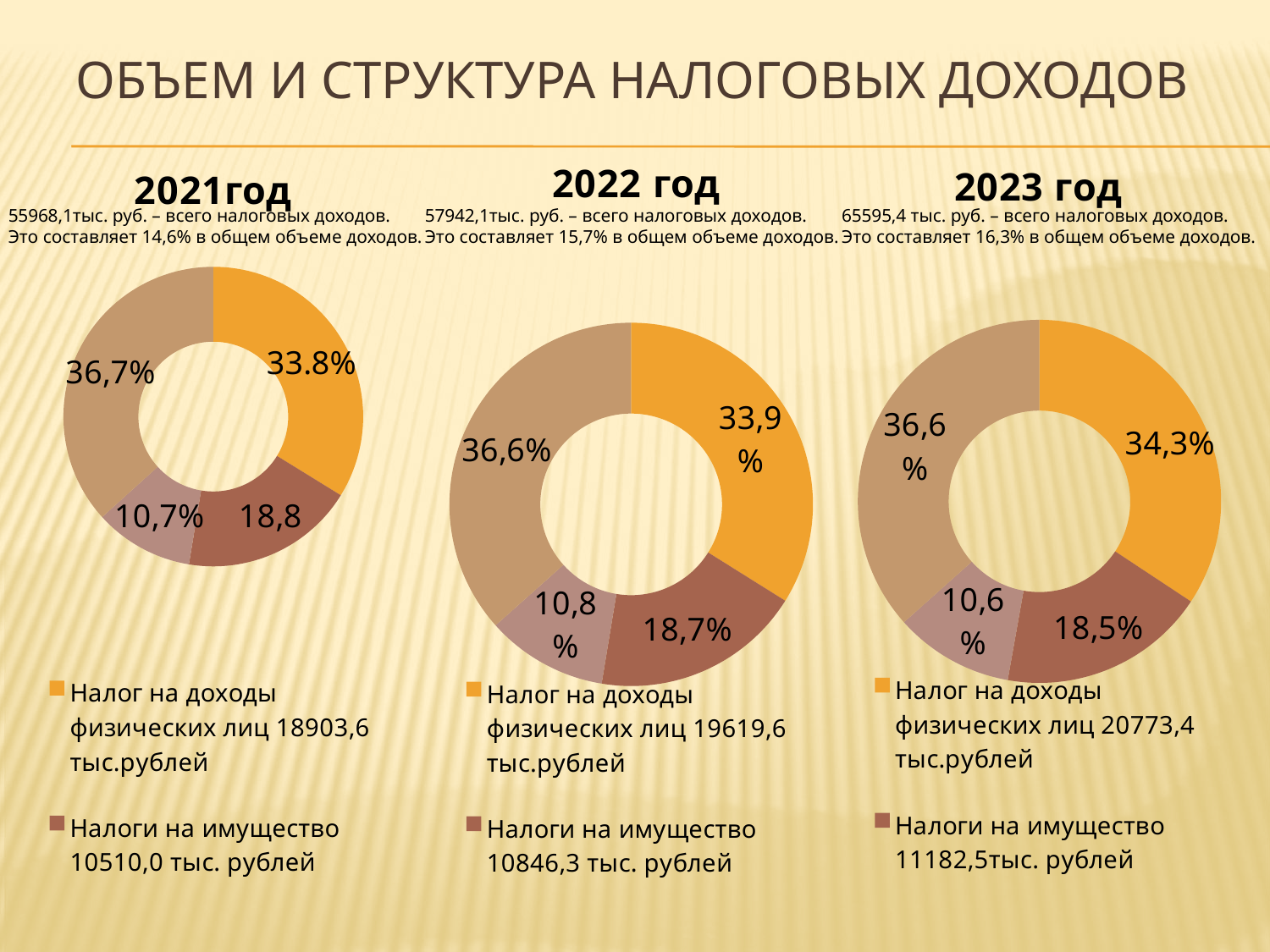
In the 2021 год chart, what is the smallest percentage shown? 10,7% Across the 2021, 2022 and 2023 charts, does the share for Налог на доходы физических лиц rise or fall? rise What is the title of the slide containing the three charts? ОБЪЕМ И СТРУКТУРА НАЛОГОВЫХ ДОХОДОВ According to the legend of the 2021 год chart, what amount is given for Налог на доходы физических лиц? 18903,6 тыс.рублей How many slices does the 2022 год chart have? 4 In the 2021 год chart, what share is shown for Налог на доходы физических лиц? 33.8% In the 2023 год chart, by how many percentage points does the Налог на доходы физических лиц share exceed the Налоги на имущество share? 15,8 What kind of chart is used for the 2021 год data? doughnut chart In the 2022 год chart, which slice is larger: Налог на доходы физических лиц or Налоги на имущество? Налог на доходы физических лиц In the 2023 год chart, what is the largest percentage shown? 36,6% In the 2023 год chart, what share is shown for Налог на доходы физических лиц? 34,3% In the 2022 год chart, what share is shown for Налоги на имущество? 18,7%